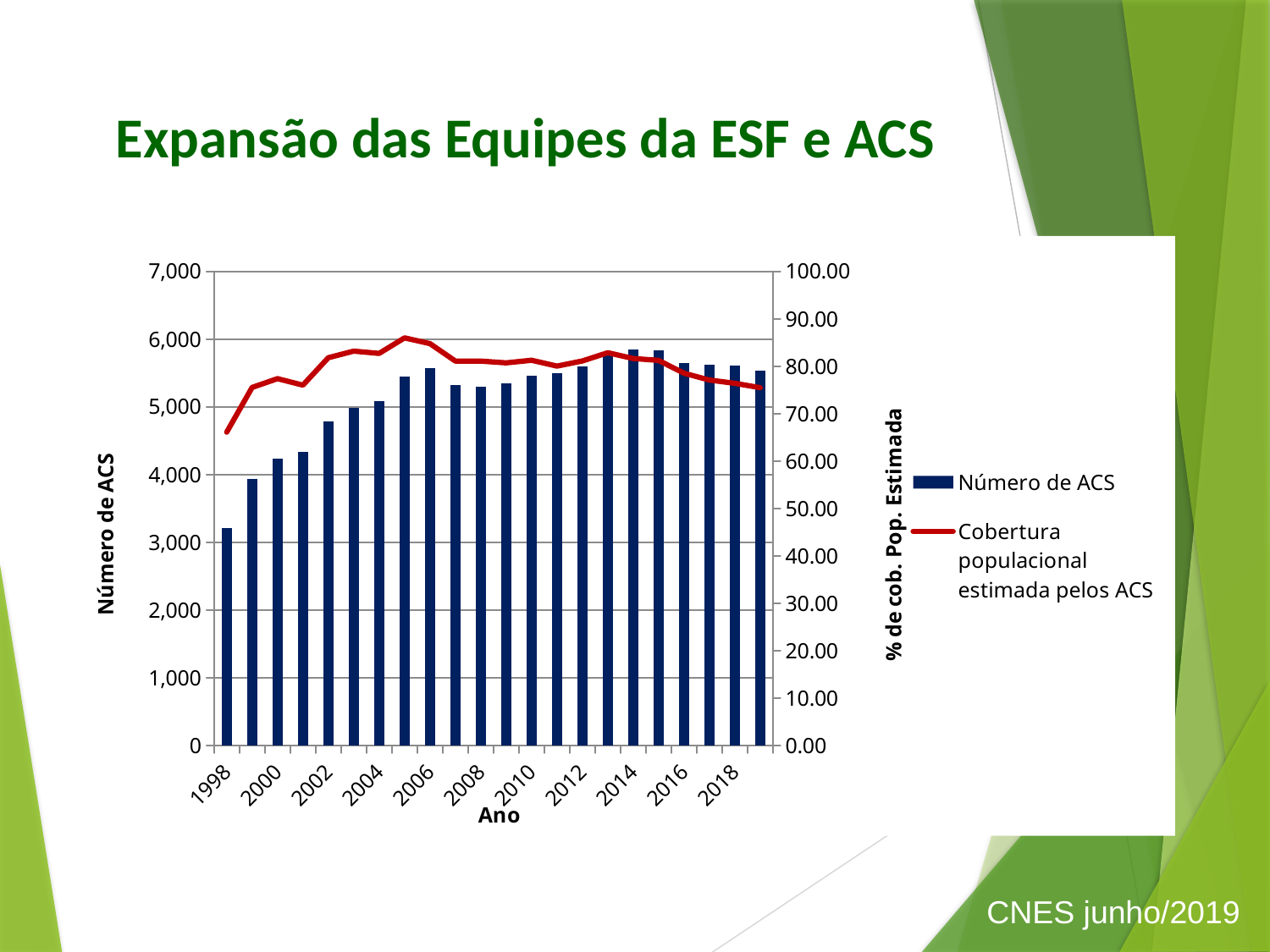
Is the Cobertura populacional estimada pelos ACS value for 1998 greater or less than 70.00? less Which year has the lowest Número de ACS bar? 1998 What are the two series named in the legend? Número de ACS; Cobertura populacional estimada pelos ACS Is the Número de ACS bar for 2006 greater or less than 5,000? greater Does the Número de ACS series rise or fall from 1998 to 2006? rise Is the Número de ACS bar for 1998 greater or less than 4,000? less Does the Cobertura populacional estimada pelos ACS line rise or fall from 2014 to the last year shown? fall What kind of chart is shown on the slide? A bar chart combined with a line chart How many series does the legend list? 2 What is the title of the slide containing the chart? Expansão das Equipes da ESF e ACS Which year has the larger Número de ACS bar, 1998 or 2006? 2006